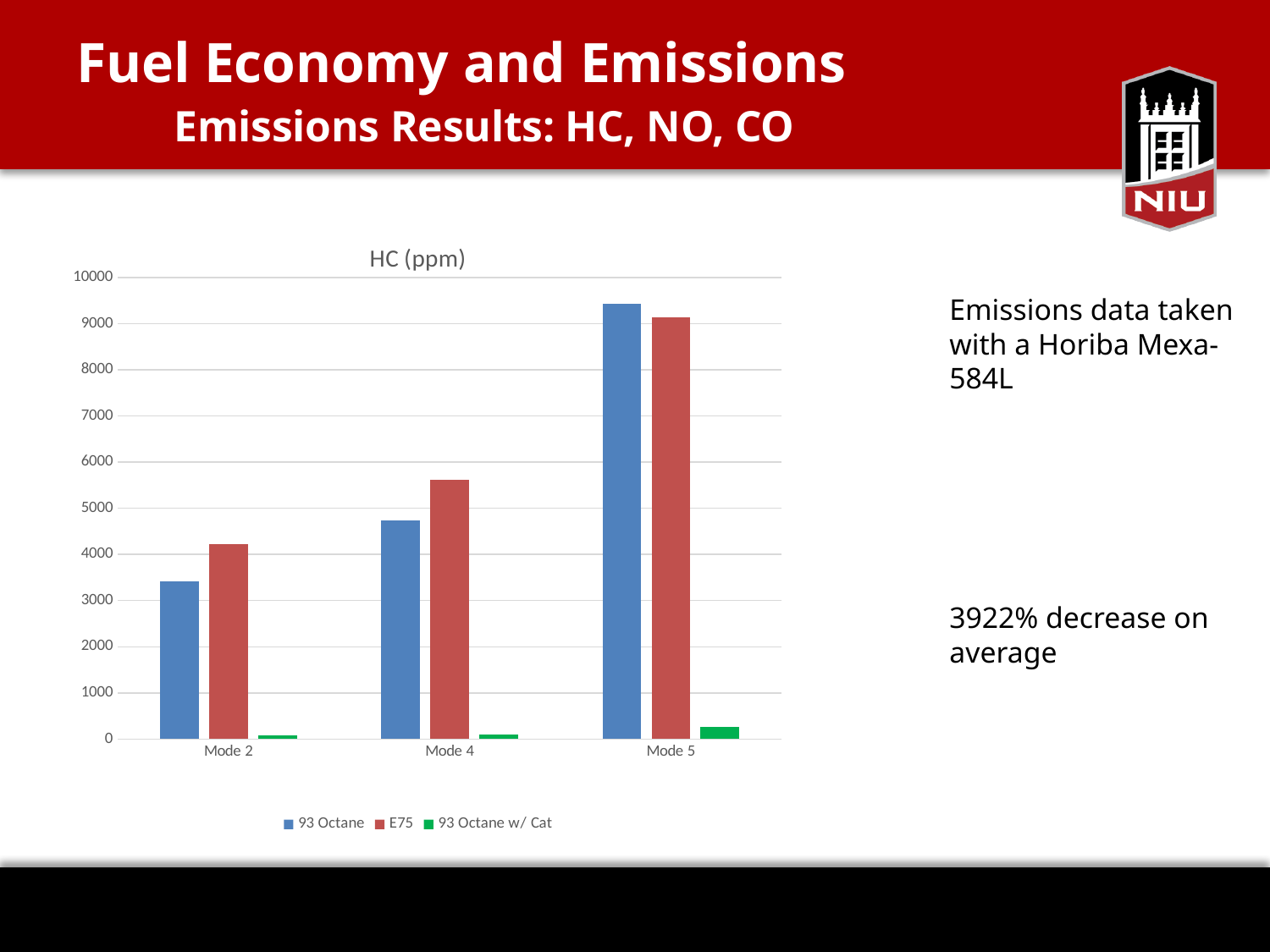
In Mode 4, which is larger: the 93 Octane value or the E75 value? E75 In which mode does the 93 Octane series reach its highest HC value? Mode 5 Is the 93 Octane value for Mode 2 greater or less than 3000? greater How many series does the chart legend list? 3 How many modes (categories) are shown on the x axis of the chart? 3 In Mode 2, which is larger: the 93 Octane value or the E75 value? E75 Which series has the lowest HC value in every mode? 93 Octane w/ Cat Is the E75 value for Mode 4 greater or less than 5000? greater Does the 93 Octane series rise or fall from Mode 2 to Mode 5? rise Which series is shown in green in the chart legend? 93 Octane w/ Cat What is the title of the chart? HC (ppm) What kind of chart is shown on the slide? bar chart